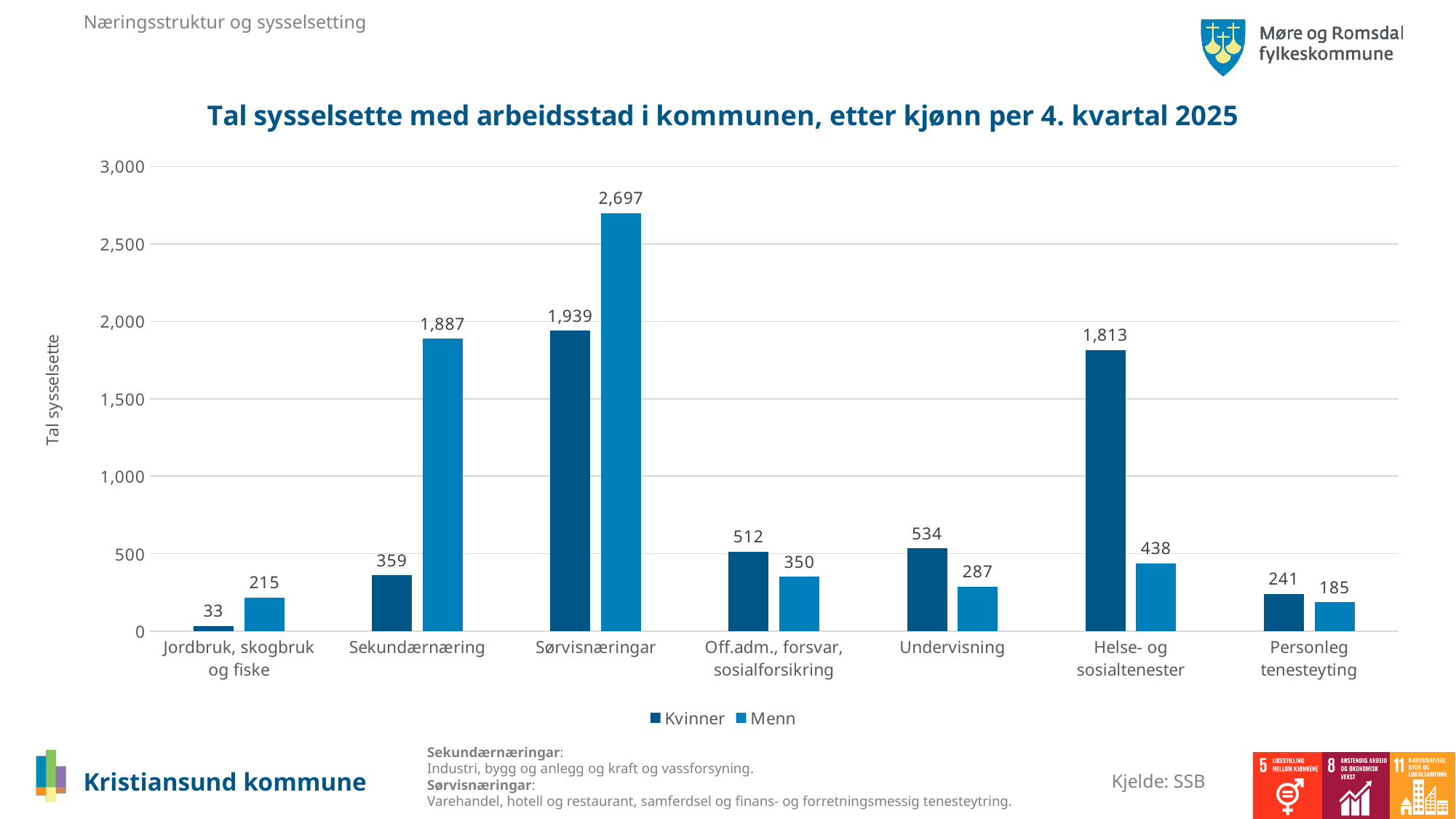
How many series does the legend list? 2 Which category has the lowest value for Kvinner? Jordbruk, skogbruk og fiske Which category has the highest value for Menn? Sørvisnæringar Is the value for Kvinner in Sørvisnæringar greater or less than 1,500? greater How many categories are shown on the x axis? 7 Which is larger in Undervisning, Kvinner or Menn? Kvinner What is the value for Kvinner in Jordbruk, skogbruk og fiske? 33 What is the difference between Menn and Kvinner in Sekundærnæring? 1,528 What is the value for Kvinner in Helse- og sosialtenester? 1,813 What is the label of the y axis? Tal sysselsette What kind of chart is shown on the slide? Bar chart What is the value for Menn in Sørvisnæringar? 2,697